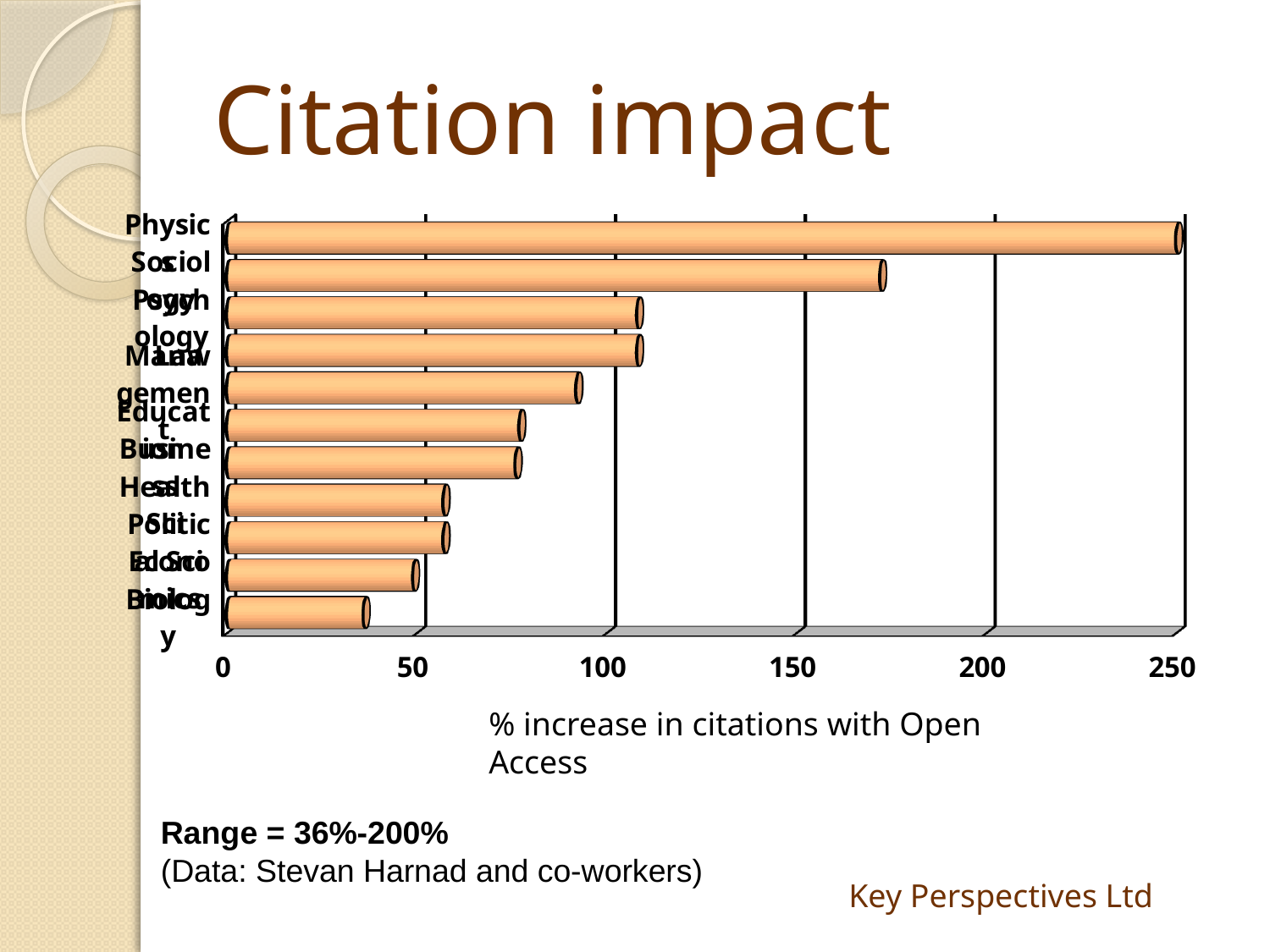
What is the highest value shown on the horizontal axis of the chart? 250 Is the value for Physics greater or less than 200? greater What is the title of the chart on the slide? Citation impact What is the label on the horizontal axis of the chart? % increase in citations with Open Access Is the value for Physics greater or less than 150? greater How many bars are plotted in the chart? 11 Do the bar lengths increase or decrease from the top bar to the bottom bar of the chart? decrease Which category has the longest bar in the chart? Physics What kind of chart is shown on the slide? Bar chart